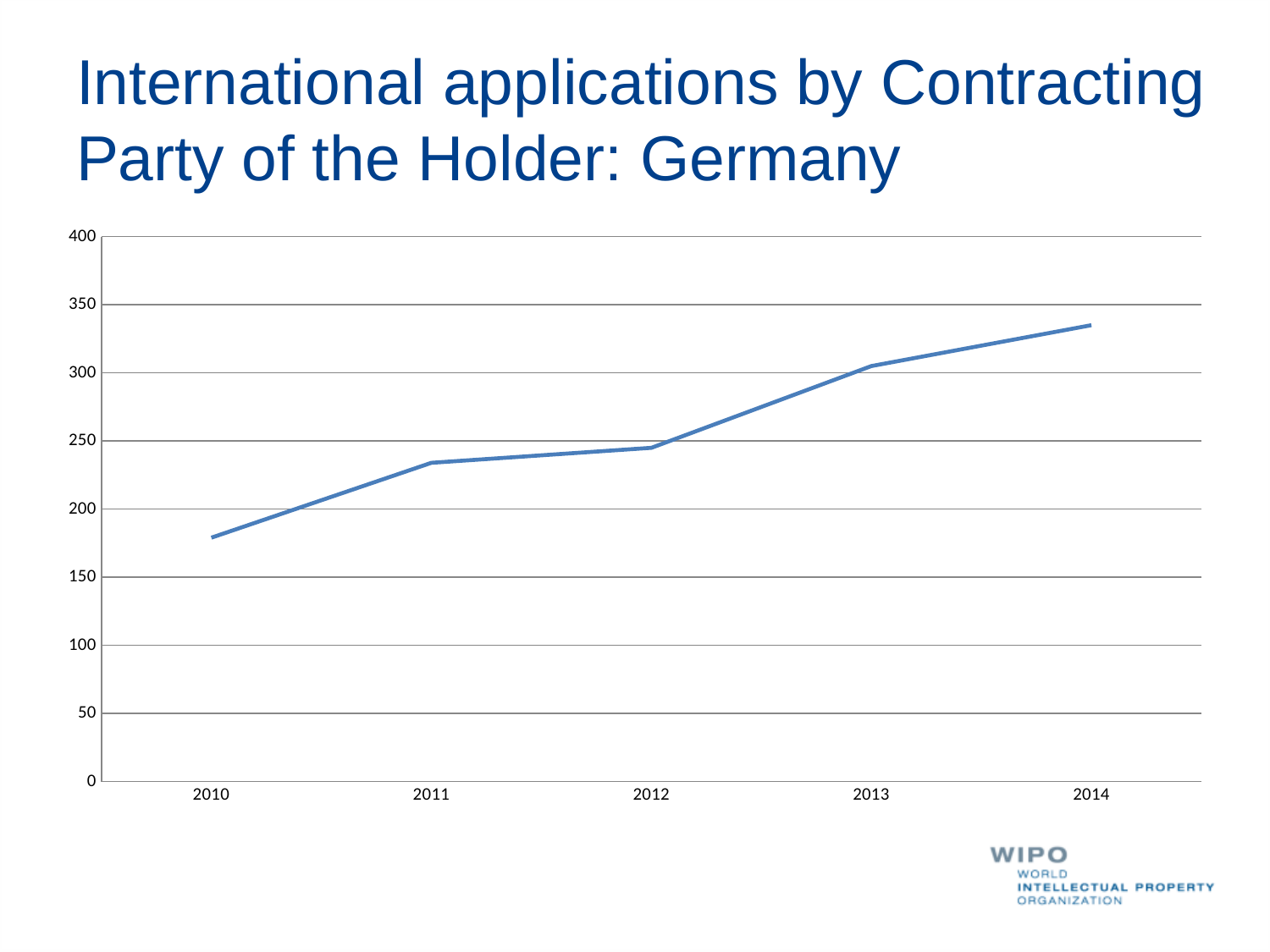
What kind of chart is shown on the slide? line chart Which year has the lowest value? 2010 Is the value for 2014 greater or less than 300? greater Which year has the highest value? 2014 Is the value for 2013 greater or less than 250? greater How many years are plotted on the x axis? 5 Is the value for 2014 greater or less than 350? less Which is larger, the value for 2011 or the value for 2013? 2013 What is the title of the chart on the slide? International applications by Contracting Party of the Holder: Germany Do the values rise or fall from 2010 to 2014? rise